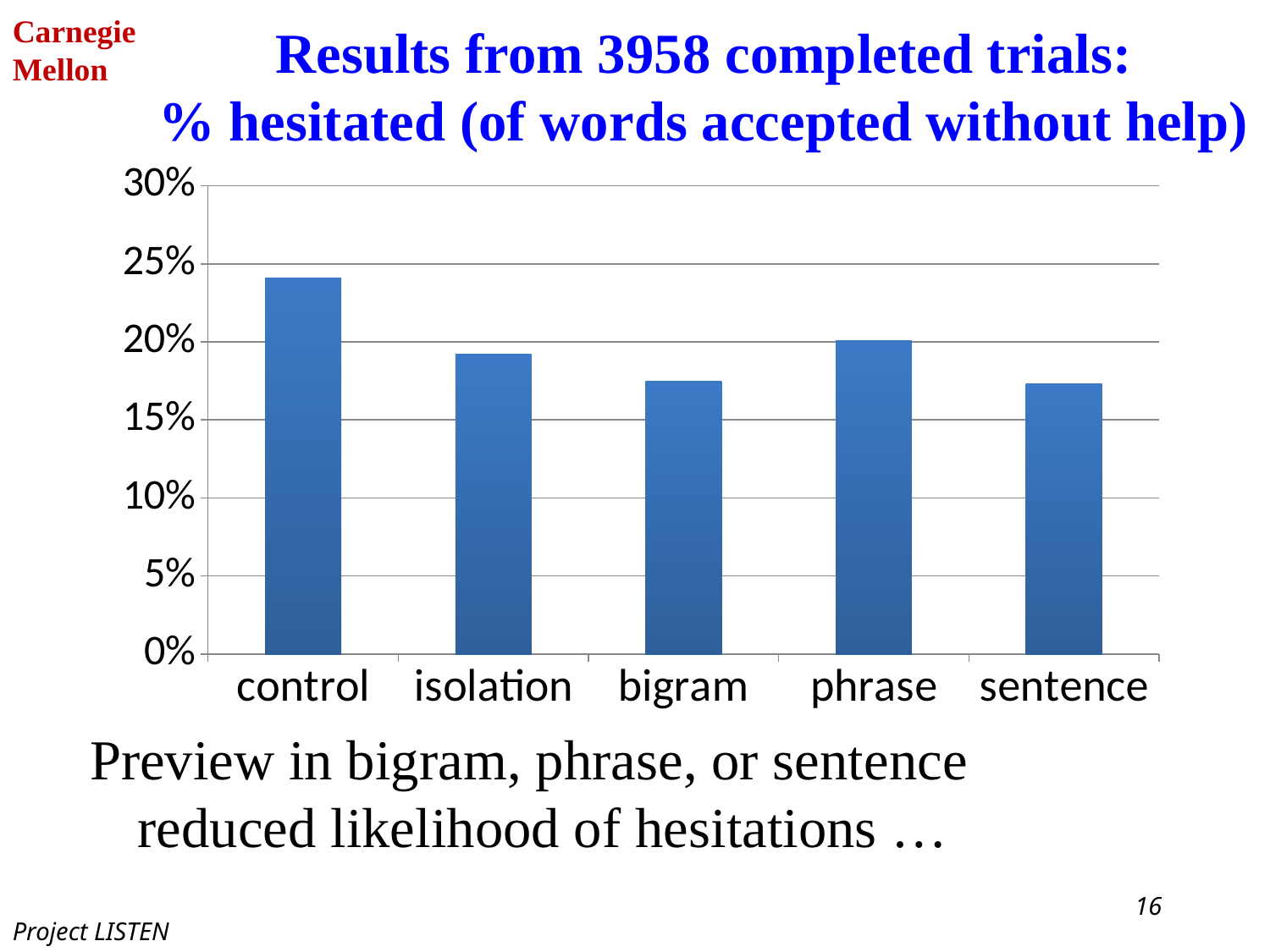
How many categories are shown on the x axis of the chart? 5 What type of chart is shown on the slide? bar chart Is the value for control greater or less than 20%? greater Is the value for bigram greater or less than 20%? less Is the value for sentence greater or less than 15%? greater What is the title of the chart? Results from 3958 completed trials: % hesitated (of words accepted without help) Which is larger, the value for phrase or the value for sentence? phrase Which is larger, the value for control or the value for phrase? control Which is larger, the value for isolation or the value for bigram? isolation Which category has the highest % hesitated? control